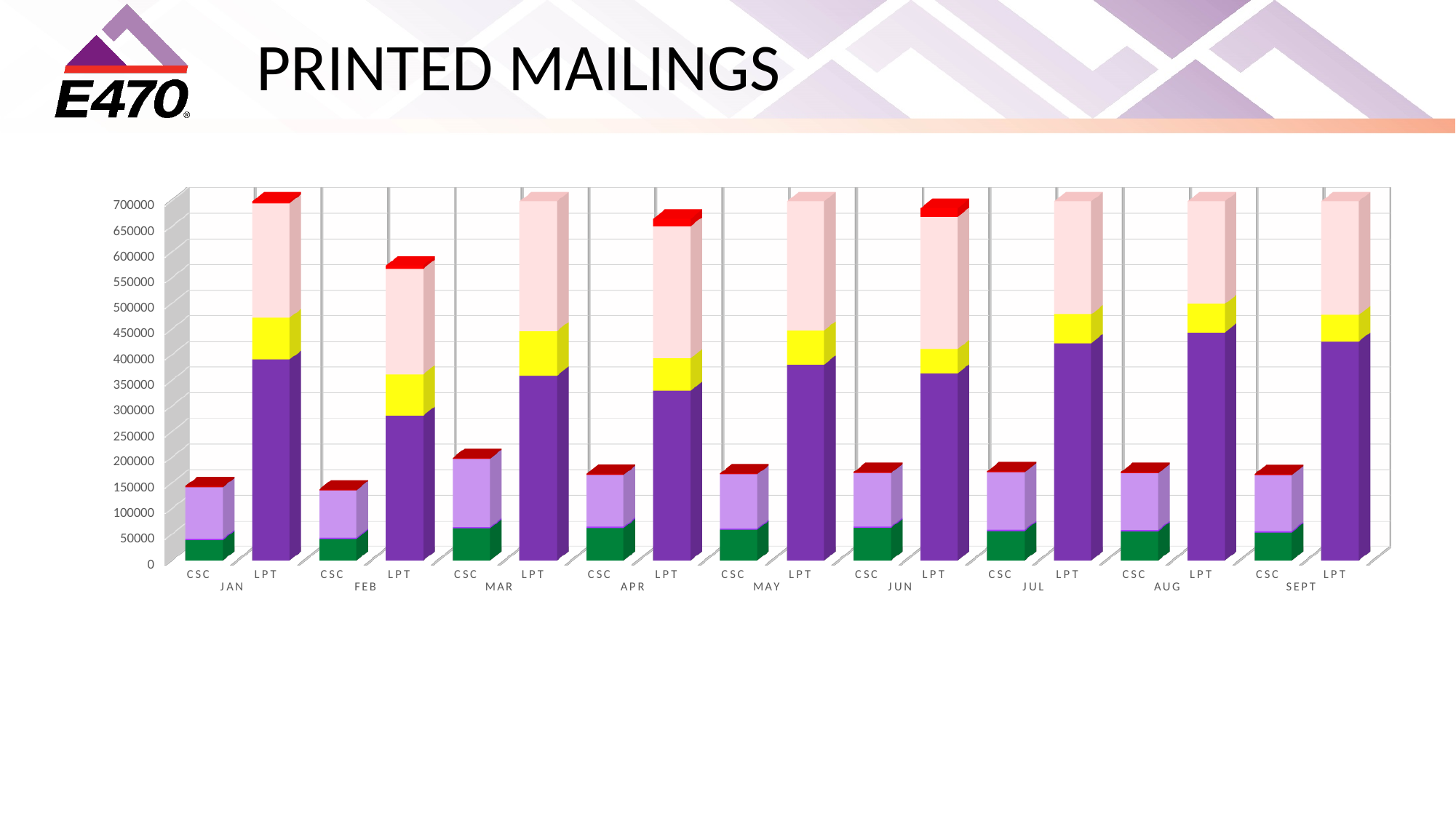
What is the title of the slide containing the chart? PRINTED MAILINGS Is the total for the CSC bar in JAN greater or less than 200000? less Which is larger, the CSC bar in MAR or the CSC bar in JAN? CSC in MAR How many bars are plotted in the chart in total? 18 What kind of chart is shown on the slide? stacked bar chart Is the total for the LPT bar in MAR greater or less than 600000? greater How many months are shown along the x axis of the chart? 9 Among the CSC bars, which month has the highest total? MAR Which is larger, the LPT bar in JAN or the LPT bar in FEB? LPT in JAN Is the total for the CSC bar in MAR greater or less than 150000? greater Among the LPT bars, which month has the lowest total? FEB